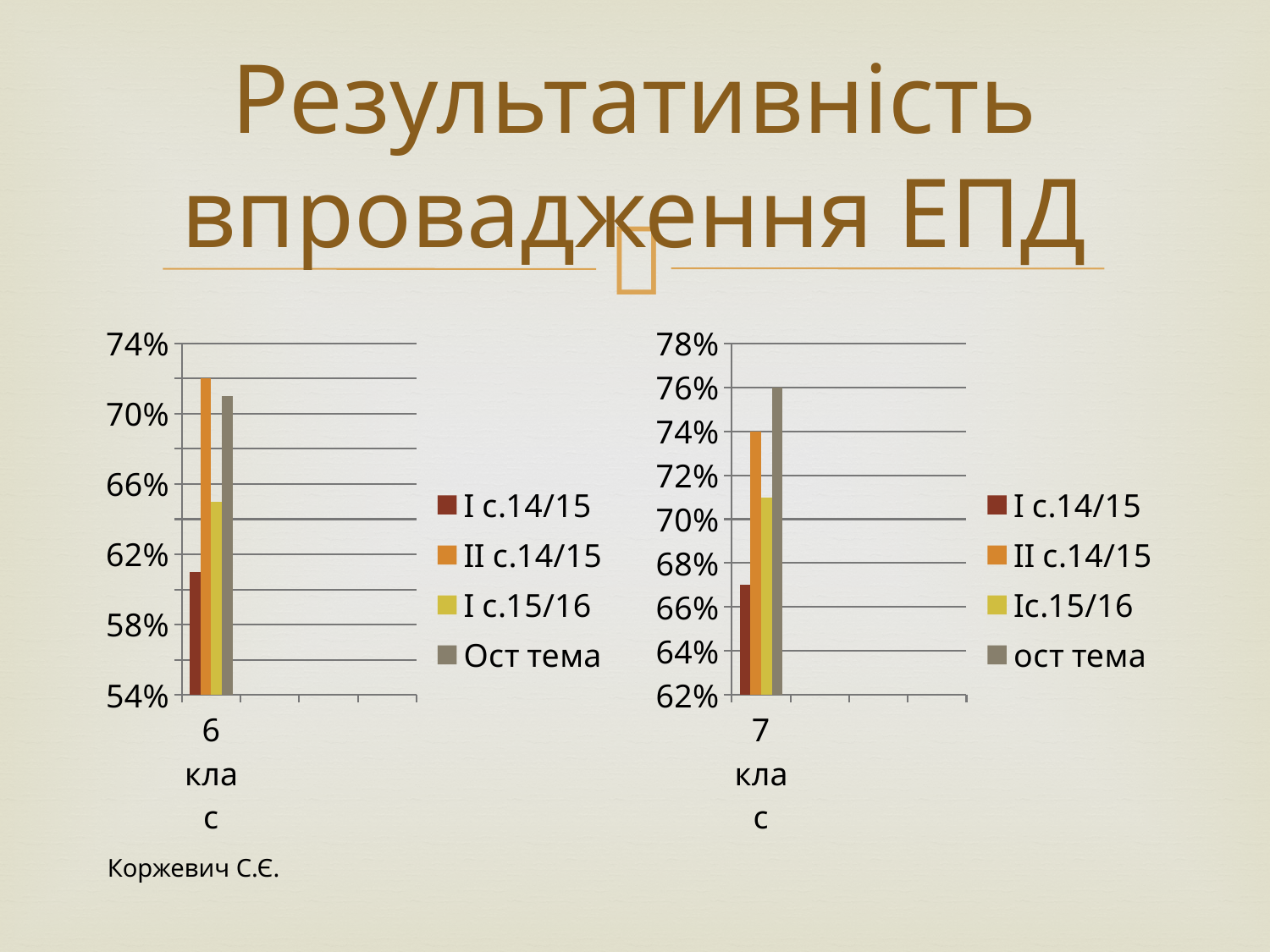
In the right chart (7 клас), is the value for I с.14/15 greater or less than 68%? less How many categories are shown on the x axis of the left chart (6 клас)? 1 In the left chart (6 клас), which series has the lowest value? I с.14/15 In the left chart (6 клас), is the value for I с.14/15 greater or less than 62%? less How many series does the legend of the right chart (7 клас) list? 4 In the left chart (6 клас), which is larger: the value for I с.15/16 or the value for Ост тема? Ост тема What kind of chart is the left chart (6 клас)? bar chart What is the x-axis category label on the right chart? 7 клас In the left chart (6 клас), which series has the highest value? II с.14/15 In the right chart (7 клас), which series has the lowest value? I с.14/15 In the right chart (7 клас), which series has the highest value? ост тема In the left chart (6 клас), is the value for II с.14/15 greater or less than 70%? greater